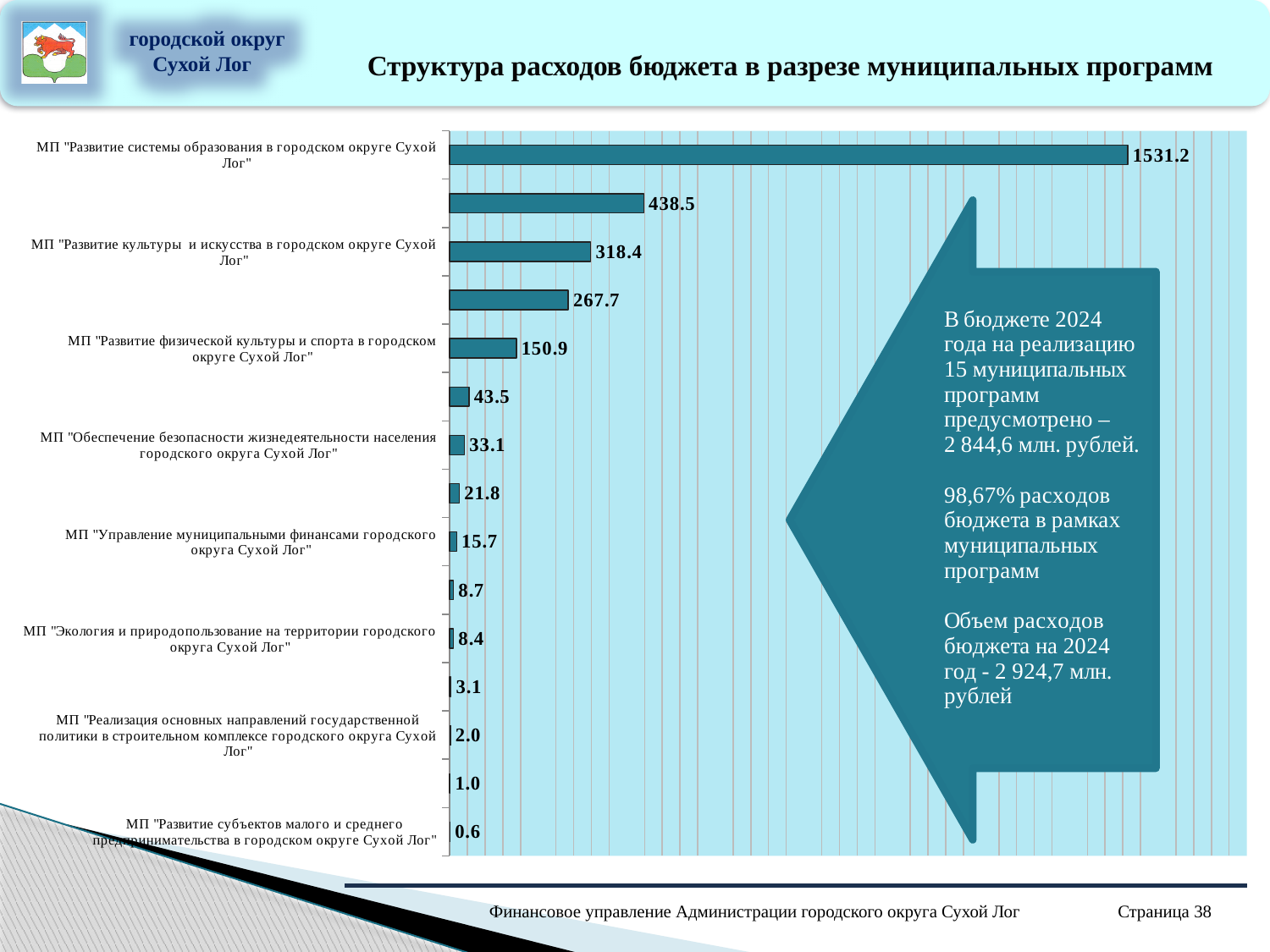
What is the value for МП "Развитие культуры и искусства в городском округе Сухой Лог"? 318.4 Which program has the lowest value in the chart? МП "Развитие субъектов малого и среднего предпринимательства в городском округе Сухой Лог" What is the value for МП "Развитие системы образования в городском округе Сухой Лог"? 1531.2 What is the title of the slide containing the chart? Структура расходов бюджета в разрезе муниципальных программ What is the value for МП "Развитие физической культуры и спорта в городском округе Сухой Лог"? 150.9 What is the difference between the values for МП "Развитие системы образования" and МП "Развитие культуры и искусства"? 1212.8 What kind of chart is shown on the slide? bar chart Which program has the highest value in the chart? МП "Развитие системы образования в городском округе Сухой Лог" How many bars are plotted in the chart? 15 Which is larger: the value for МП "Развитие физической культуры и спорта" or МП "Управление муниципальными финансами"? МП "Развитие физической культуры и спорта" What is the value for МП "Развитие субъектов малого и среднего предпринимательства в городском округе Сухой Лог"? 0.6 What is the value for МП "Обеспечение безопасности жизнедеятельности населения городского округа Сухой Лог"? 33.1